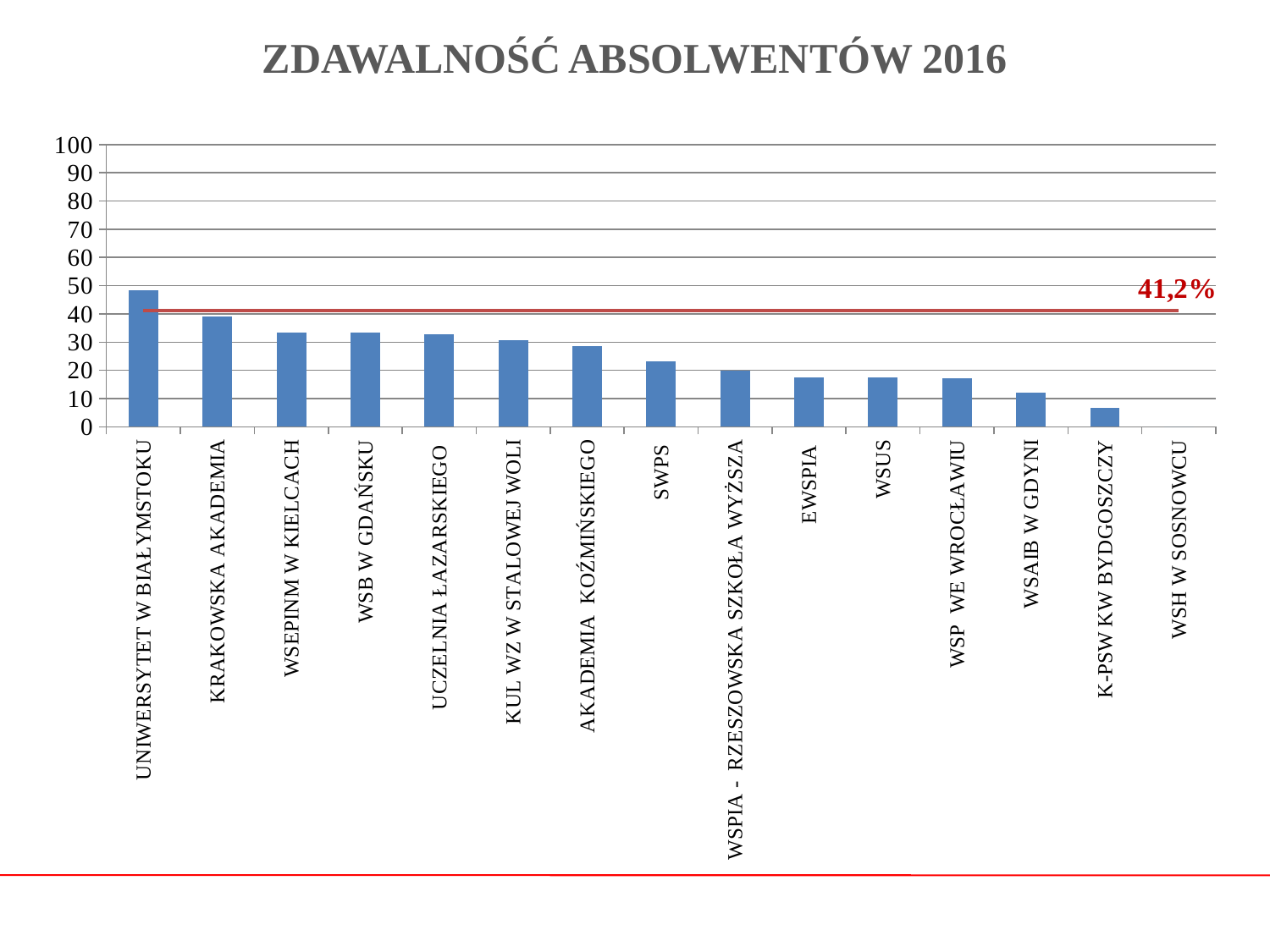
How many categories (institutions) are shown on the x axis? 15 Is the value for K-PSW KW BYDGOSZCZY greater or less than 10? less Is the value for KRAKOWSKA AKADEMIA greater or less than 50? less Is the value for SWPS greater or less than 20? greater What is the title of the chart? ZDAWALNOŚĆ ABSOLWENTÓW 2016 What kind of chart is shown on the slide? bar chart Which institution has the highest value? UNIWERSYTET W BIAŁYMSTOKU Which is larger, the value for KRAKOWSKA AKADEMIA or the value for SWPS? KRAKOWSKA AKADEMIA Do the values generally rise or fall from left to right along the x axis? fall What value is printed next to the red horizontal line? 41,2%